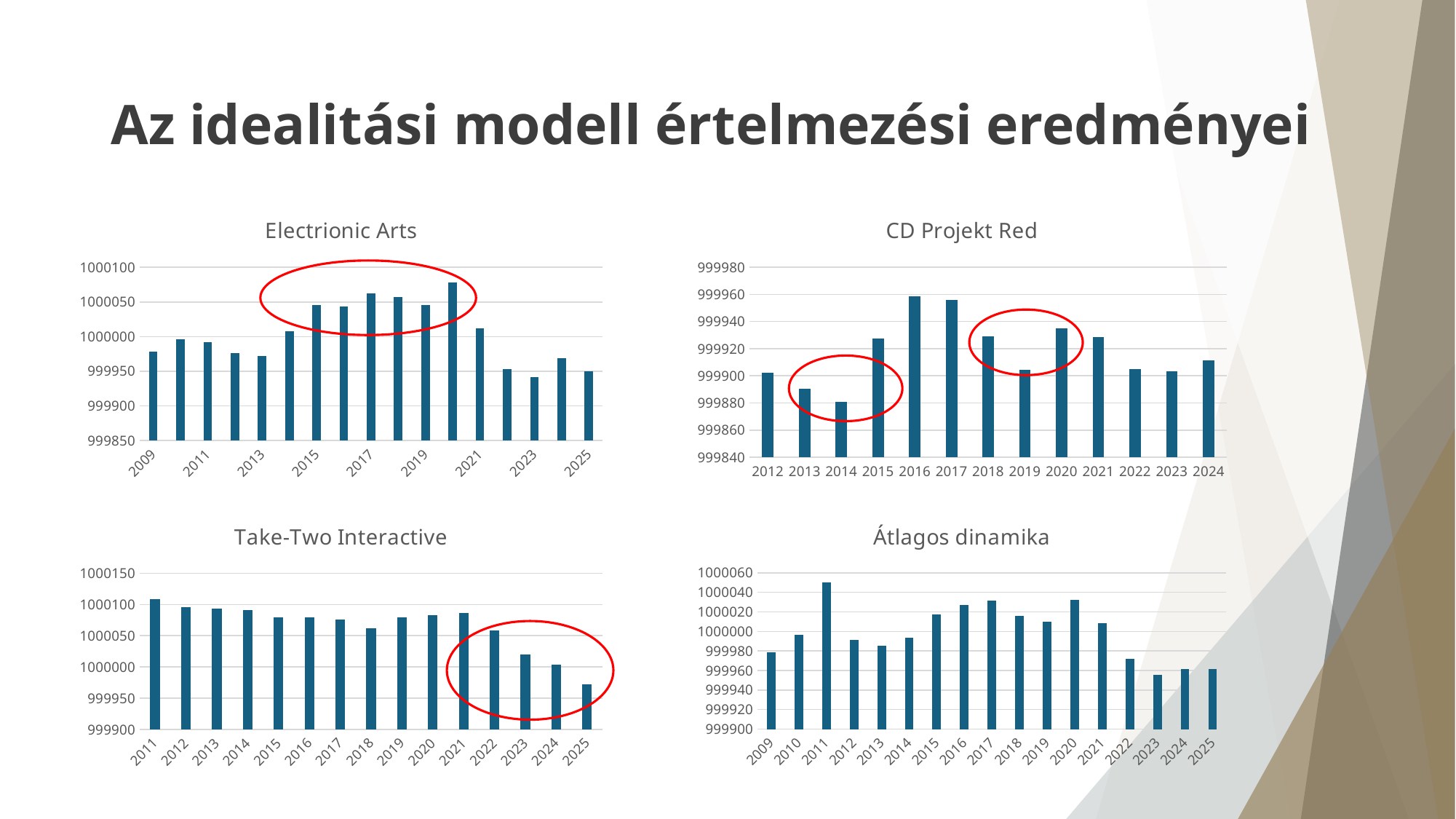
In the Take-Two Interactive chart, do the values generally rise or fall from 2011 to 2025? fall In the CD Projekt Red chart, is the value for 2014 greater or less than 999900? less In the Electronic Arts chart, which year has the lowest value? 2023 In the Take-Two Interactive chart, which year has the highest value? 2011 In the Electronic Arts chart, which year has the highest value? 2020 In the CD Projekt Red chart, how many years are shown on the x axis? 13 What kind of chart is the Átlagos dinamika chart? bar chart In the CD Projekt Red chart, which year has the lowest value? 2014 In the Take-Two Interactive chart, is the value for 2025 greater or less than 1000000? less In the Átlagos dinamika chart, which year has the highest value? 2011 In the Electronic Arts chart, is the value for 2020 greater or less than 1000050? greater In the Átlagos dinamika chart, which is larger, the value for 2020 or the value for 2023? 2020